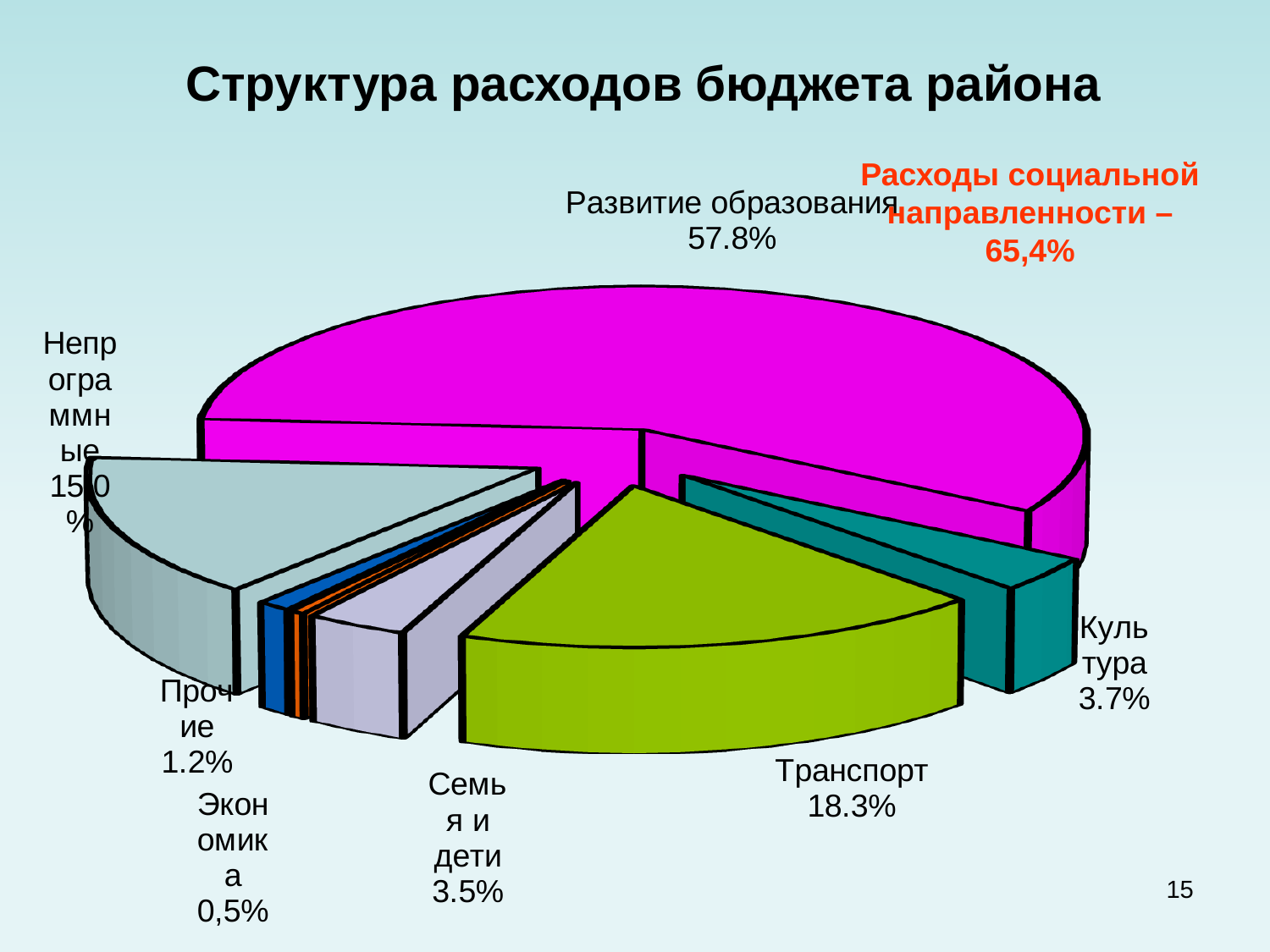
What is the value shown for Экономика? 0,5% What is the value shown for Семья и дети? 3.5% What is the value shown for Прочие? 1.2% What kind of chart is shown on the slide? pie chart Which is larger, the share for Культура or the share for Семья и дети? Культура What is the value shown for Культура? 3.7% What is the difference between the shares of Развитие образования and Транспорт? 39.5% What share of the pie does Развитие образования have? 57.8% Which category has the largest share of the pie? Развитие образования Which category has the smallest share of the pie? Экономика What is the value shown for Транспорт? 18.3% What is the title of the chart? Структура расходов бюджета района